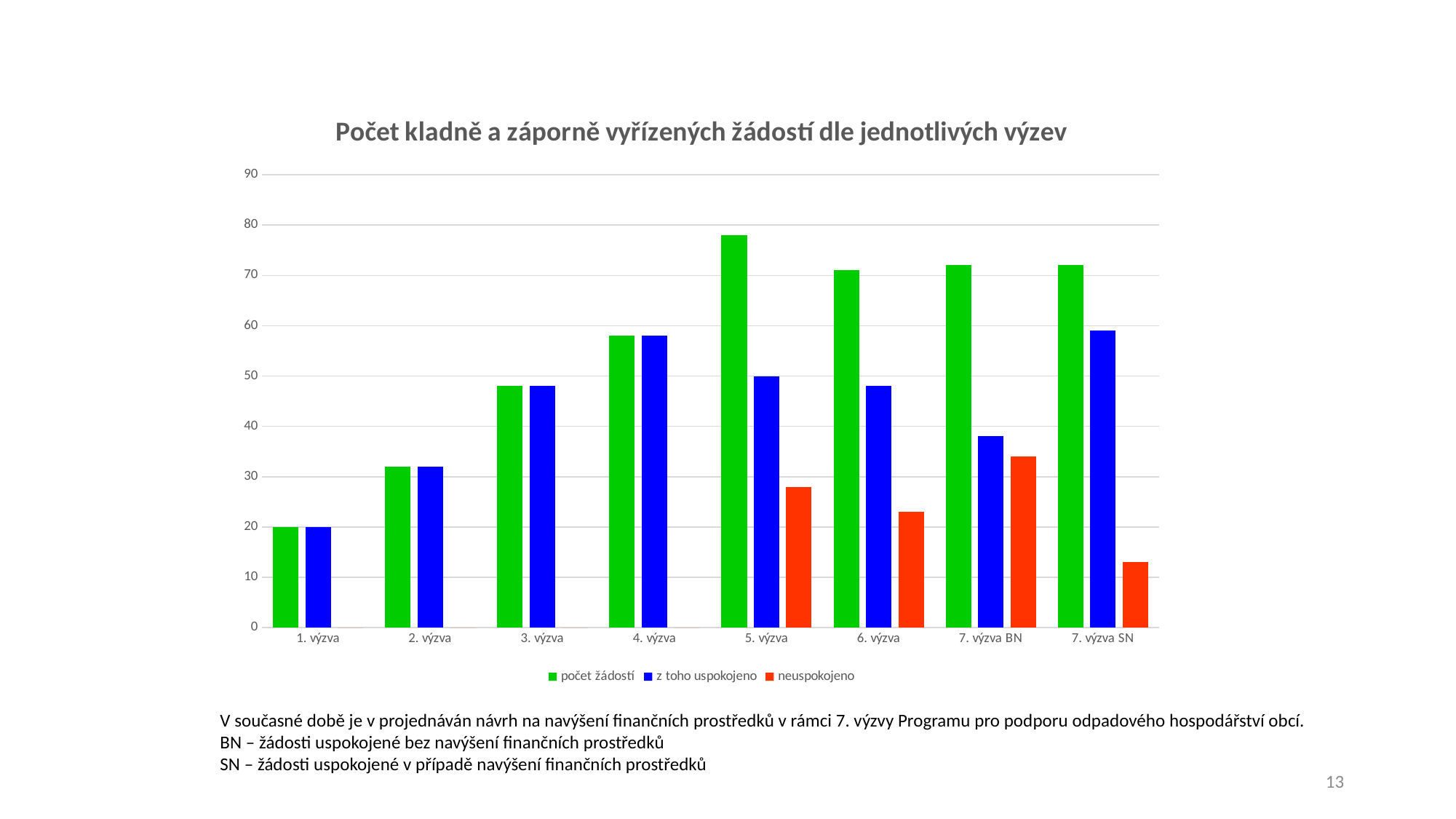
How many series does the legend list? 3 Is the value of 'neuspokojeno' for 7. výzva SN greater or less than 20? less What kind of chart is shown on the slide? bar chart Does the value of 'počet žádostí' rise or fall from 1. výzva to 5. výzva? rise Which category has the highest value for 'neuspokojeno'? 7. výzva BN Which category has the lowest value for 'počet žádostí'? 1. výzva What is the value of 'z toho uspokojeno' for 5. výzva? 50 What is the value of 'počet žádostí' for 1. výzva? 20 Which is larger: 'z toho uspokojeno' for 5. výzva or for 7. výzva SN? 7. výzva SN Which category has the highest value for 'počet žádostí'? 5. výzva How many categories (výzvy) are shown on the x axis? 8